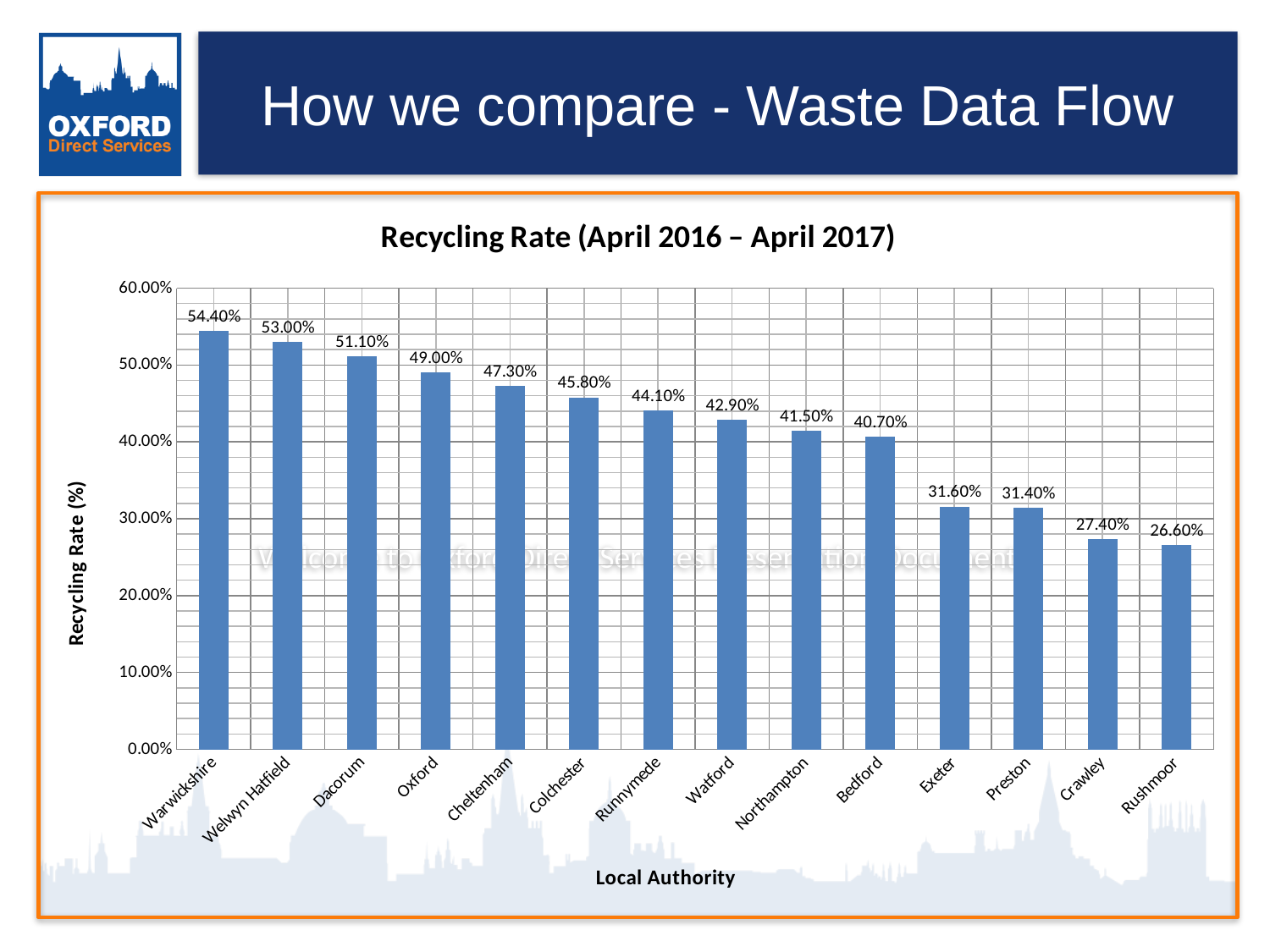
What is the label of the y axis? Recycling Rate (%) What kind of chart is shown on the slide? Bar chart Do the recycling rates rise or fall from left to right along the x axis? Fall Which local authority has the highest recycling rate? Warwickshire What is the recycling rate for Oxford? 49.00% What is the title of the chart? Recycling Rate (April 2016 – April 2017) Is the value for Bedford greater or less than 40.00%? greater What is the recycling rate for Northampton? 41.50% What is the difference between the recycling rates of Warwickshire and Rushmoor? 27.80% Which local authority has the lowest recycling rate? Rushmoor How many local authorities are shown in the chart? 14 Which has a higher recycling rate, Cheltenham or Watford? Cheltenham